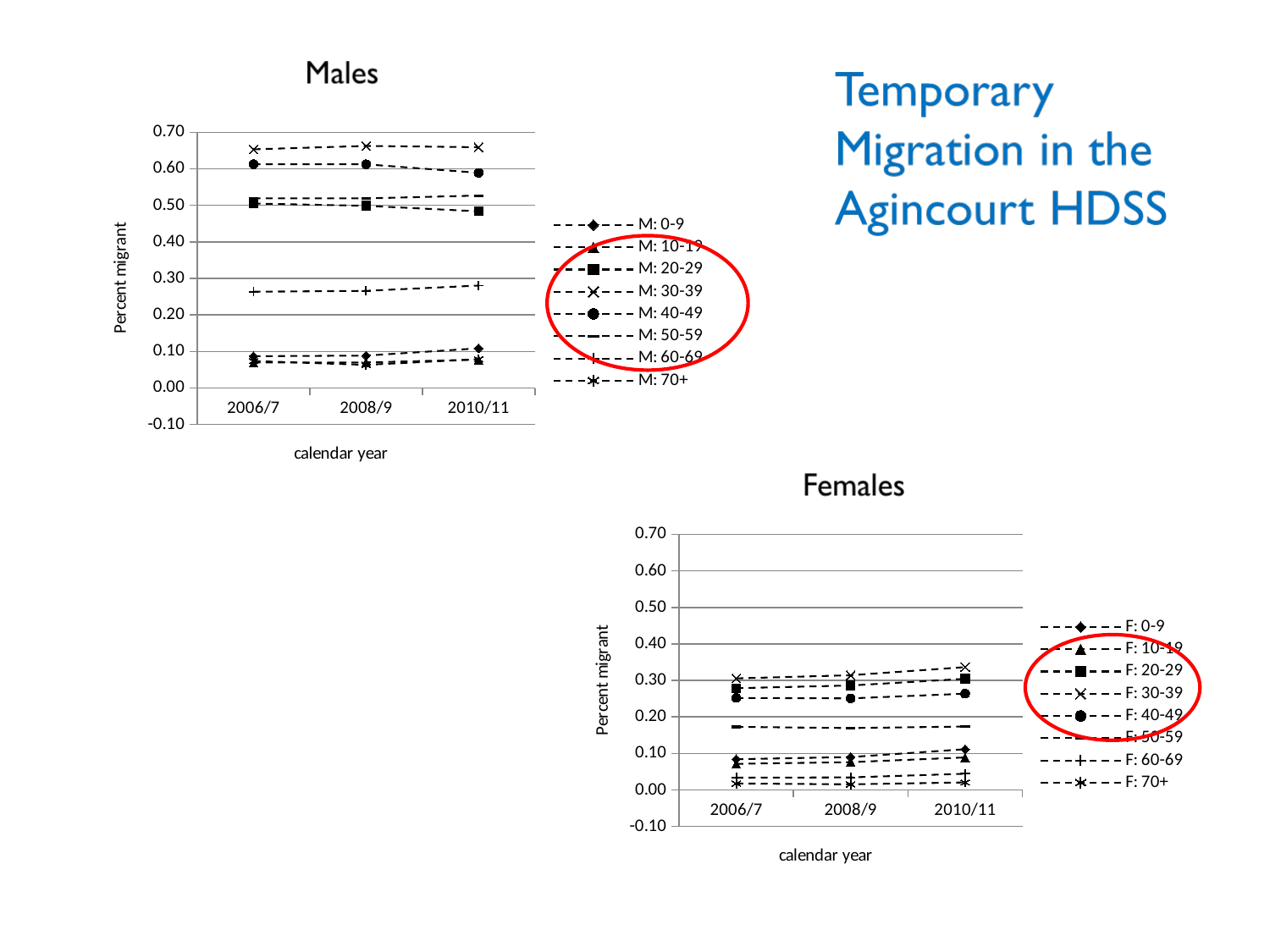
What is the x-axis title of the Females chart? calendar year In the Males chart, which series has the highest values across all years? M: 30-39 In the Males chart, which is larger in 2008/9: M: 30-39 or M: 60-69? M: 30-39 In the Females chart, which series has the highest value in 2010/11? F: 30-39 In the Males chart, is the value for M: 60-69 in 2006/7 greater or less than 0.30? less How many calendar-year points are plotted along the x axis of the Males chart? 3 In the Males chart, is the value for M: 30-39 in 2006/7 greater or less than 0.60? greater How many series does the legend of the Females chart list? 8 In the Females chart, does the F: 30-39 series rise or fall from 2006/7 to 2010/11? rise What kind of chart is the Males chart? line chart In the Females chart, is the value for F: 50-59 in 2008/9 greater or less than 0.20? less